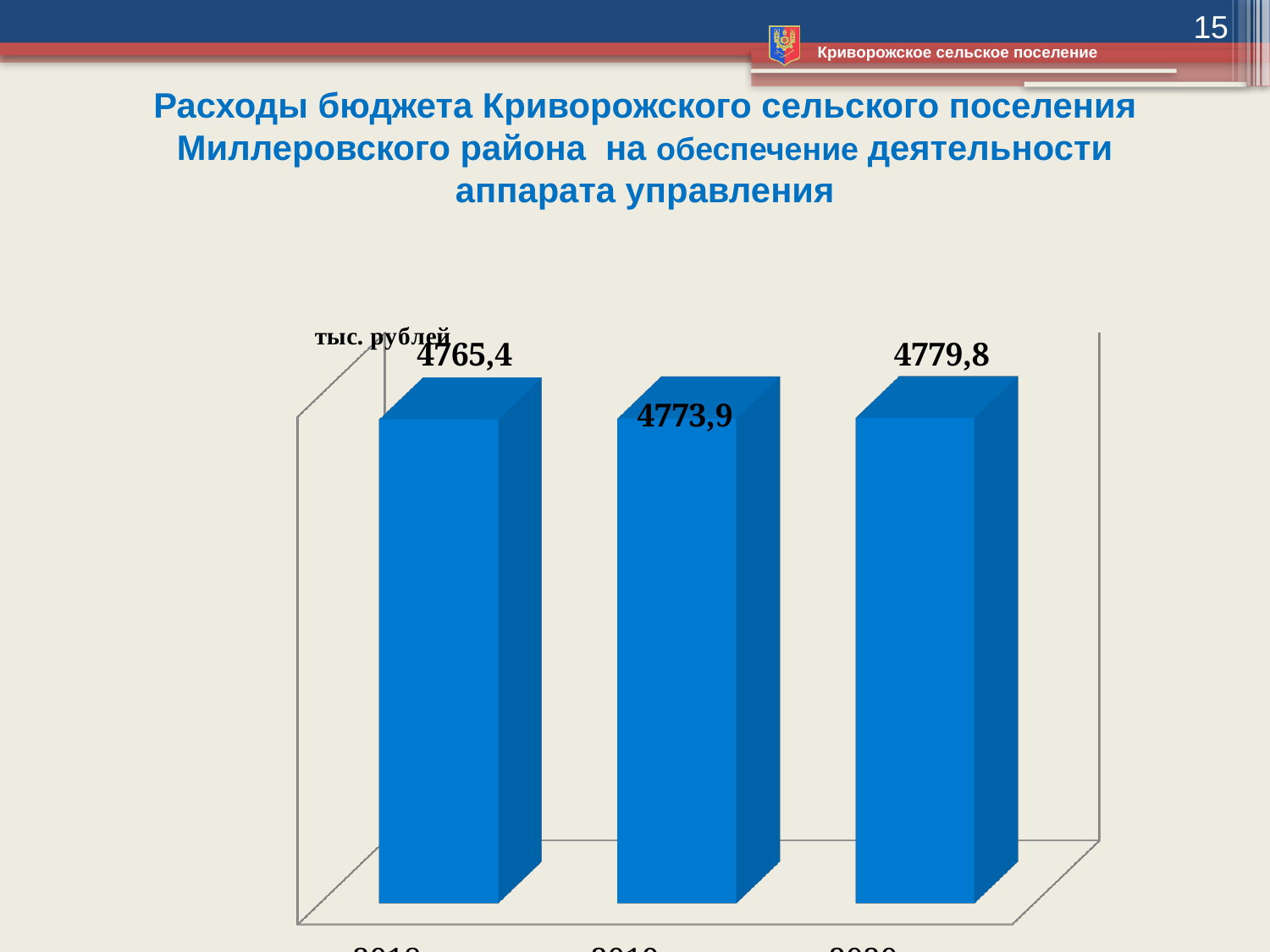
Do the values rise or fall from left to right across the bars? rise What is the value shown on the middle bar? 4773,9 What is the value shown on the leftmost bar? 4765,4 Which is larger, the value of the middle bar or the value of the rightmost bar? the rightmost bar Which bar has the highest value: the left, middle or right one? right What kind of chart is shown on the slide? bar chart Which bar has the lowest value: the left, middle or right one? left What unit is indicated at the top left of the chart? тыс. рублей What is the difference between the rightmost bar's value and the leftmost bar's value? 14,4 What is the difference between the middle bar's value and the leftmost bar's value? 8,5 How many bars are plotted in the chart? 3 What is the value shown on the rightmost bar? 4779,8